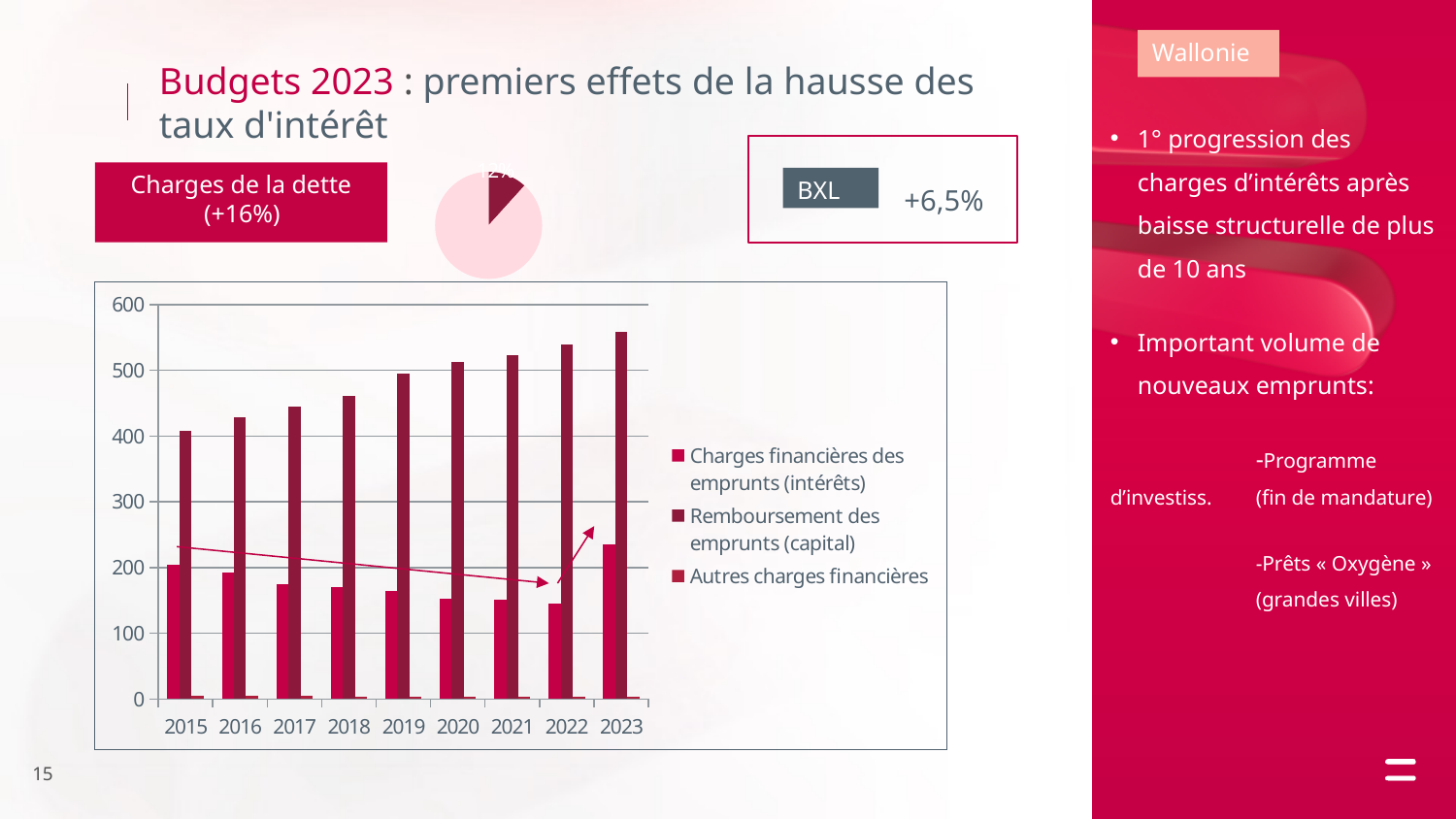
How many series does the legend of the bar chart list? 3 Do the bars for Remboursement des emprunts (capital) rise or fall from 2015 to 2023? rise Is the value for Remboursement des emprunts (capital) in 2023 greater or less than 500? greater What is the first entry in the legend of the bar chart? Charges financières des emprunts (intérêts) Which is larger: Charges financières des emprunts (intérêts) in 2015 or in 2022? 2015 Is the value for Remboursement des emprunts (capital) in 2019 greater or less than 400? greater Which year has the lowest bar for Remboursement des emprunts (capital)? 2015 Which year has the highest bar for Remboursement des emprunts (capital)? 2023 What kind of chart is shown on the slide? a pie chart and a bar chart How many years are shown on the x axis of the bar chart? 9 Is the value for Charges financières des emprunts (intérêts) in 2015 greater or less than 300? less